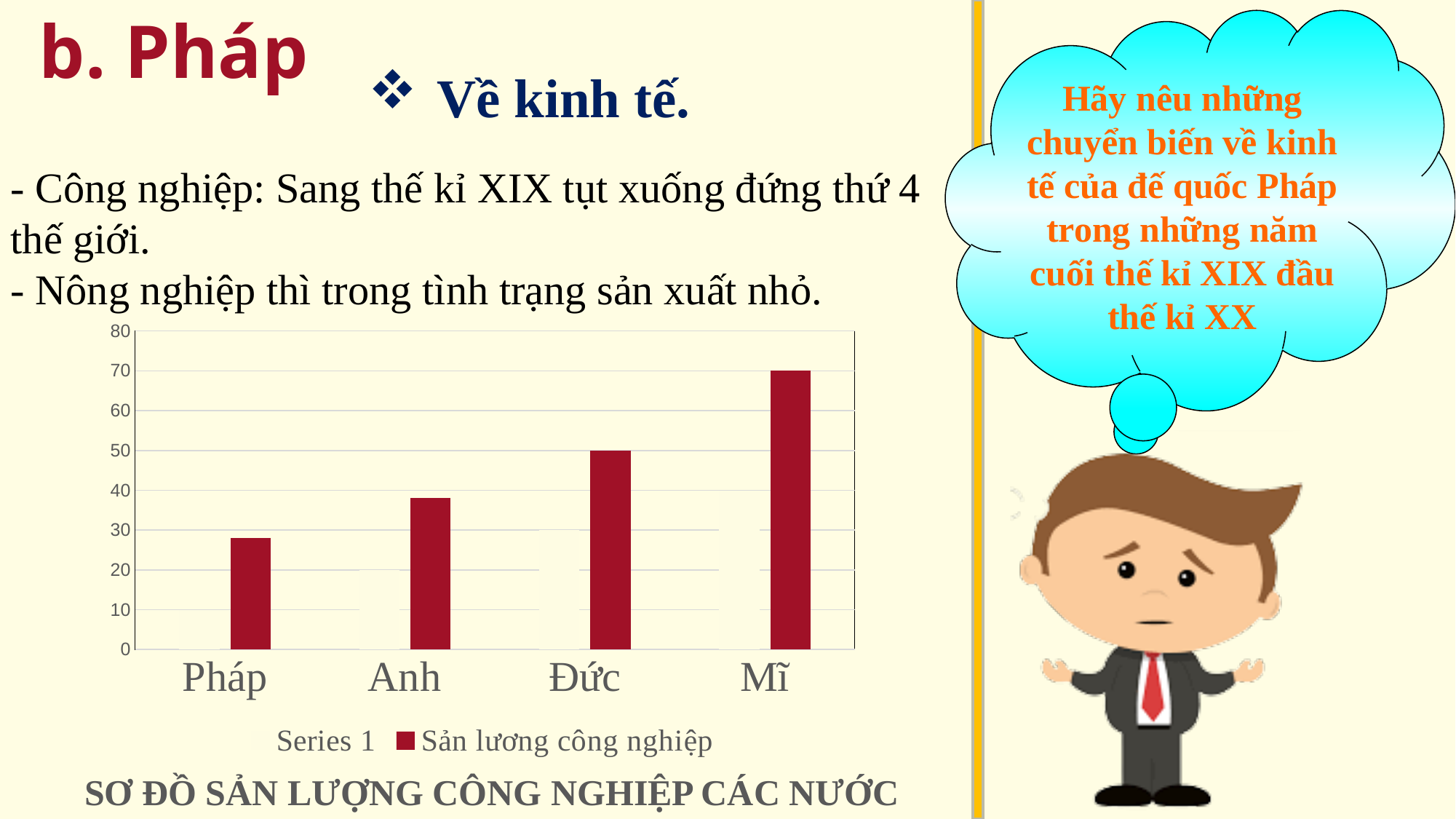
Which country has the highest bar in the chart? Mĩ How many countries are shown on the x axis of the chart? 4 Which has a larger value, Anh or Đức? Đức What is the difference between the values for Mĩ and Đức? 20 What is the caption/title written below the chart? SƠ ĐỒ SẢN LƯỢNG CÔNG NGHIỆP CÁC NƯỚC Is the value for Pháp greater or less than 30? less What type of chart is shown on the slide? Bar chart Is the value for Anh greater or less than 30? greater What is the value for Đức in the chart? 50 What is the value for Mĩ in the chart? 70 Which country has the lowest bar in the chart? Pháp Do the bar values rise or fall from left to right across the x axis? Rise